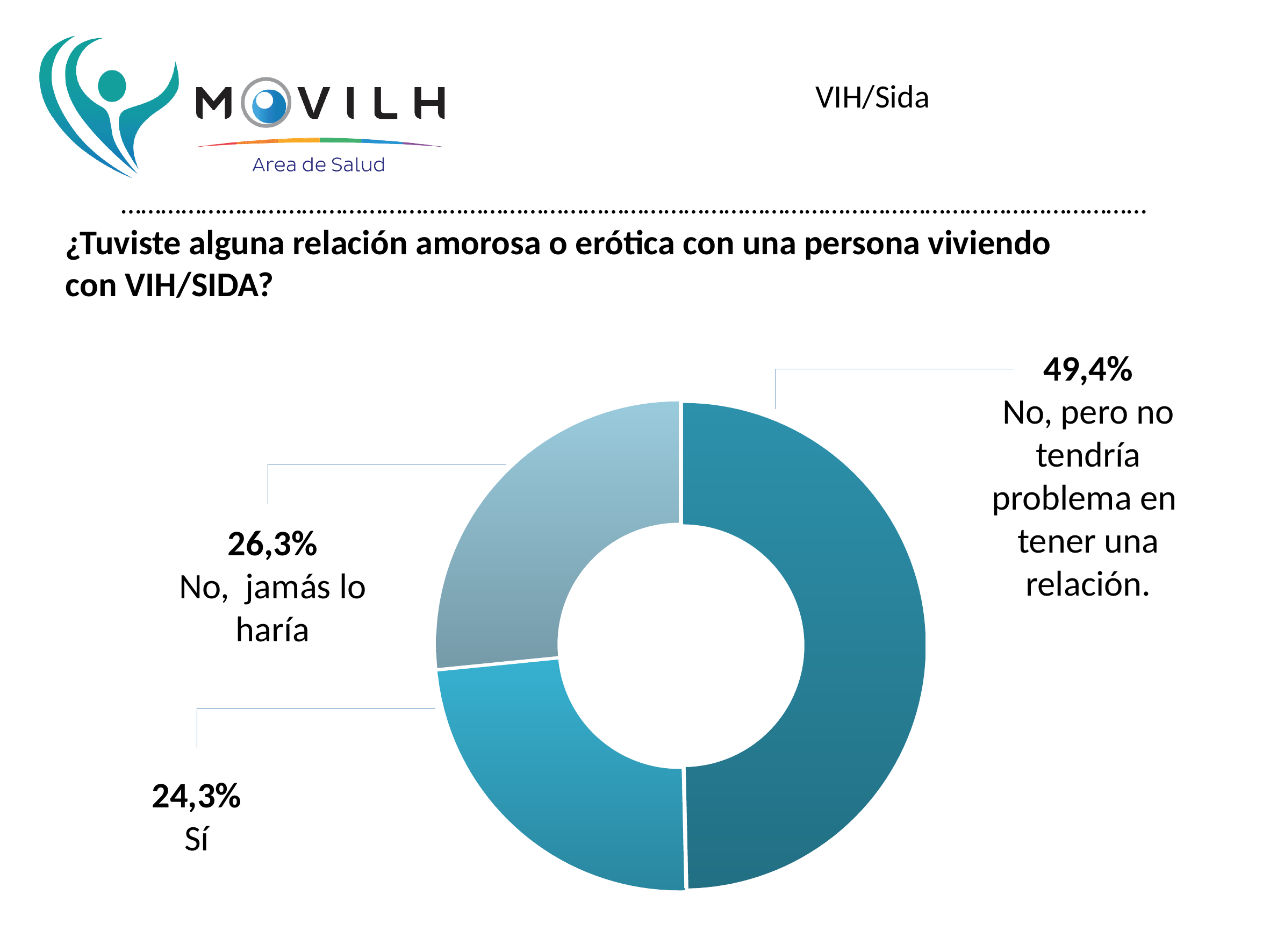
What percentage of respondents answered "No, jamás lo haría"? 26,3% Which is larger: the share for "No, jamás lo haría" or the share for "Sí"? No, jamás lo haría What percentage of respondents answered "No, pero no tendría problema en tener una relación"? 49,4% How many response categories are shown in the chart? 3 What is the difference in percentage points between "No, jamás lo haría" and "Sí"? 2,0 What kind of chart is shown on the slide? Doughnut (pie) chart What question does the chart on the slide answer? ¿Tuviste alguna relación amorosa o erótica con una persona viviendo con VIH/SIDA? What percentage of respondents answered "Sí"? 24,3% Which response has the largest share of the chart? No, pero no tendría problema en tener una relación. Which response has the smallest share of the chart? Sí What is the difference in percentage points between "No, pero no tendría problema en tener una relación" and "Sí"? 25,1 What is the combined share of the two "No" responses? 75,7%